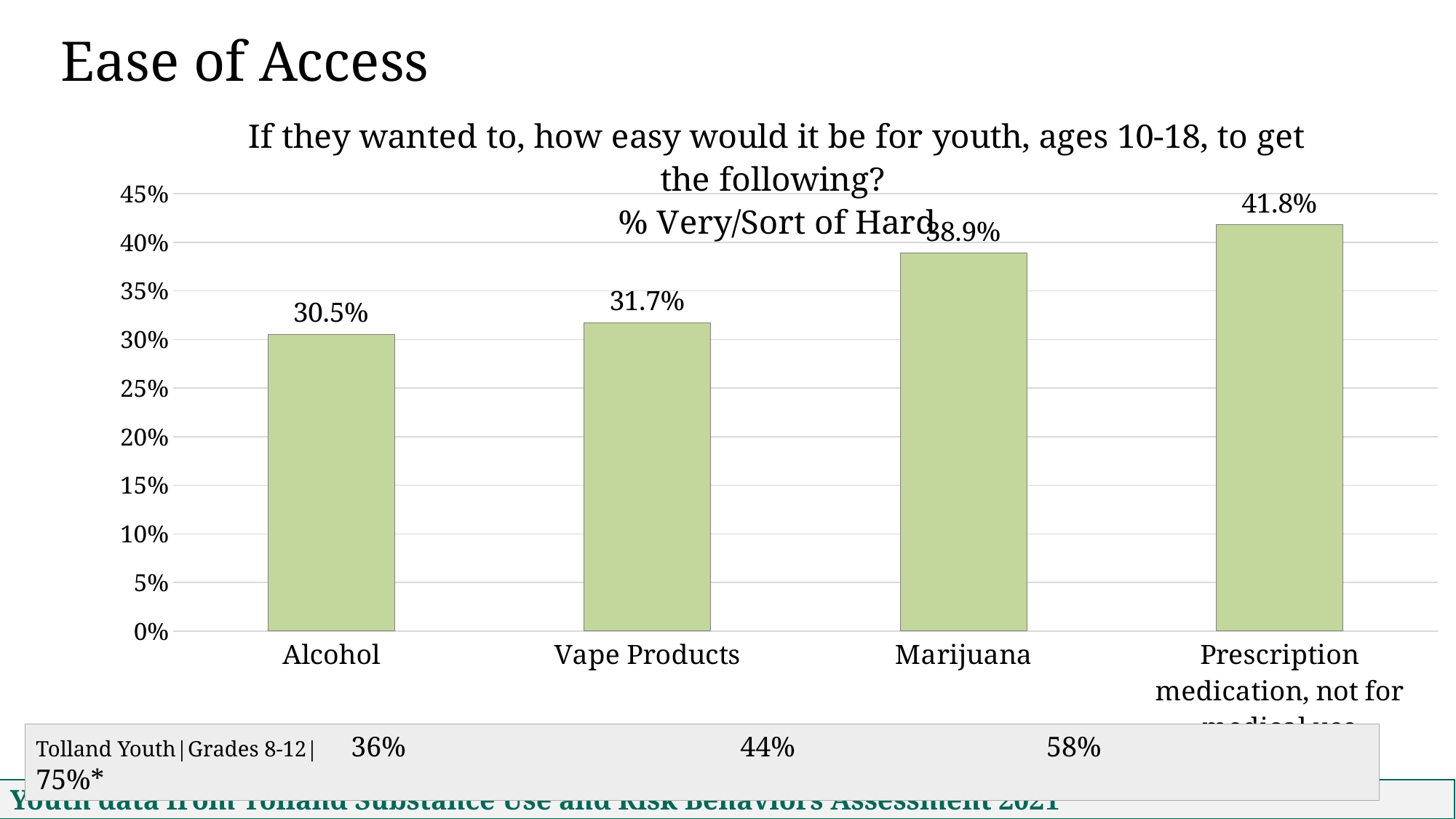
Which is larger, the value for Marijuana or the value for Vape Products? Marijuana What is the value for Vape Products? 31.7% What kind of chart is shown on the slide? Bar chart What is the value for Marijuana? 38.9% What is the difference between the values for Marijuana and Alcohol? 8.4% Do the values rise or fall from left to right across the categories? Rise Which category has the highest value? Prescription medication, not for medical use How many categories are shown on the chart? 4 What is the value for Alcohol? 30.5% What is the difference between the values for Prescription medication, not for medical use and Vape Products? 10.1% Which category has the lowest value? Alcohol What is the value for Prescription medication, not for medical use? 41.8%